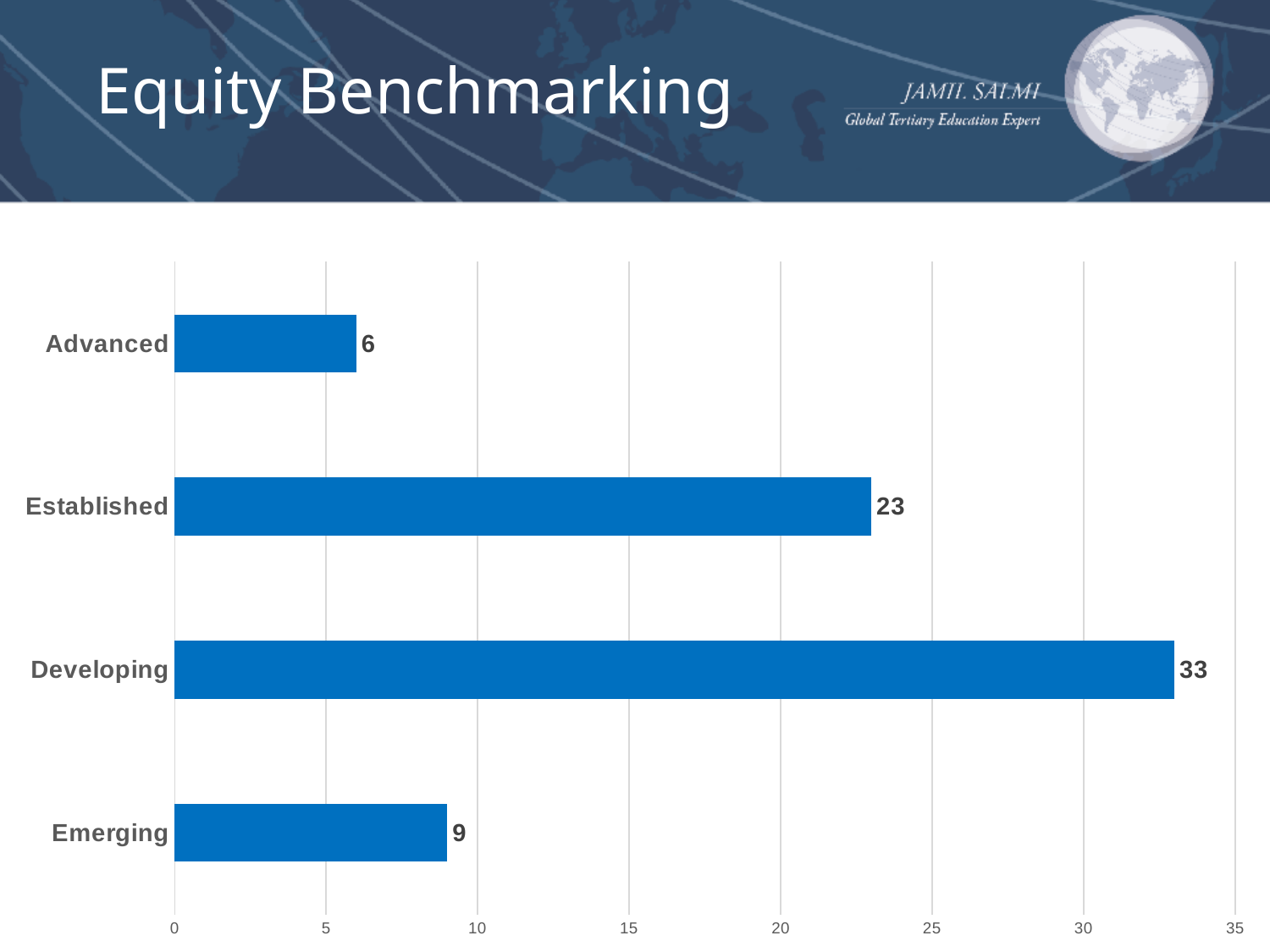
What is the title of the slide? Equity Benchmarking Which category has the highest value? Developing What is the value for Established? 23 What is the value for Advanced? 6 What kind of chart is shown on the slide? Bar chart What is the value for Emerging? 9 What is the value for Developing? 33 What is the difference between the values for Developing and Established? 10 Which category has the lowest value? Advanced Which is larger, the value for Established or the value for Emerging? Established How many categories are shown in the chart? 4 What is the difference between the values for Emerging and Advanced? 3